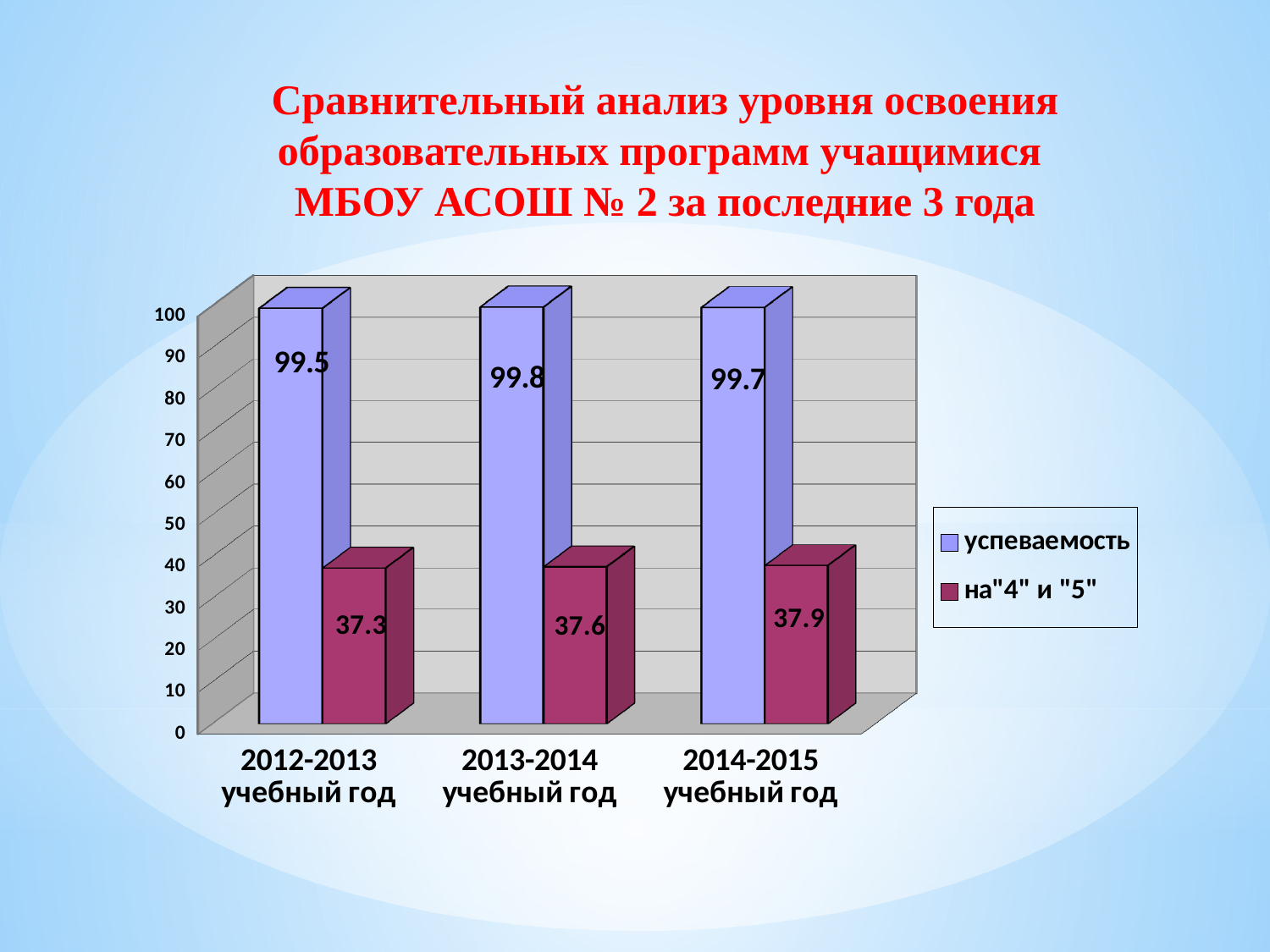
In which school year is на"4" и "5" lowest? 2012-2013 учебный год By how much did на"4" и "5" change from 2012-2013 to 2014-2015 учебный год? 0.6 How many series does the legend list? 2 What is the value of на"4" и "5" for 2013-2014 учебный год? 37.6 Does на"4" и "5" rise or fall across the school years from 2012-2013 to 2014-2015? rise How many school years are shown on the x axis? 3 What is the value of на"4" и "5" for 2014-2015 учебный год? 37.9 Which is larger: на"4" и "5" in 2013-2014 or in 2014-2015 учебный год? 2014-2015 учебный год What is the value of успеваемость for 2012-2013 учебный год? 99.5 What is the difference between успеваемость and на"4" и "5" in 2014-2015 учебный год? 61.8 In which school year is успеваемость highest? 2013-2014 учебный год What kind of chart is shown on the slide? bar chart